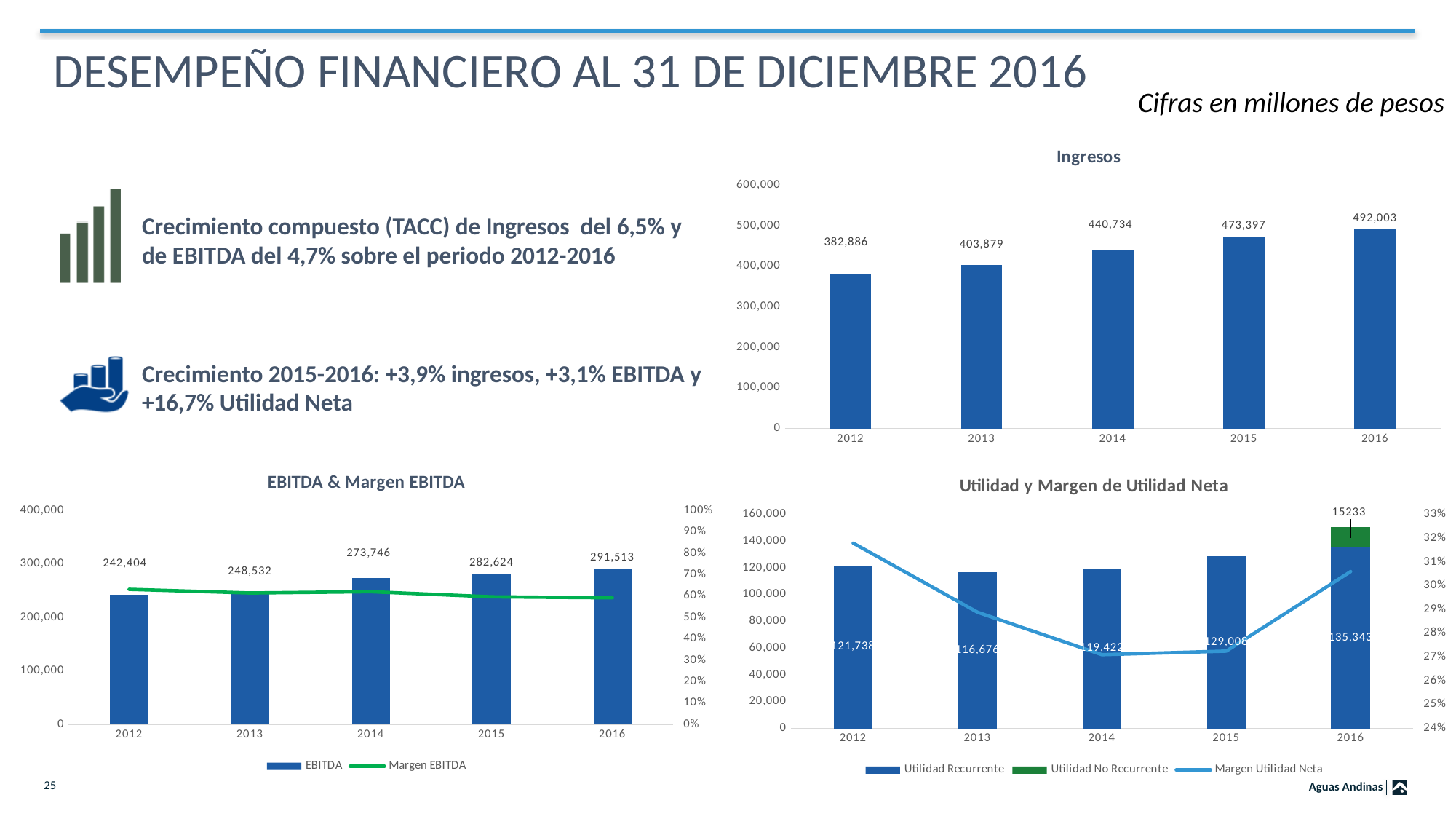
In the EBITDA & Margen EBITDA chart, what is the EBITDA value for 2013? 248,532 In the Utilidad y Margen de Utilidad Neta chart, which is larger, the Utilidad Recurrente for 2013 or for 2014? 2014 In the Ingresos chart, what is the value for 2014? 440,734 In the EBITDA & Margen EBITDA chart, is the Margen EBITDA for 2012 greater or less than 50%? greater In the EBITDA & Margen EBITDA chart, which year has the lowest EBITDA? 2012 In the Utilidad y Margen de Utilidad Neta chart, is the Margen Utilidad Neta for 2012 greater or less than 30%? greater In the Ingresos chart, do the values rise or fall from 2012 to 2016? rise In the Ingresos chart, which year has the highest value? 2016 In the EBITDA & Margen EBITDA chart, how many series does the legend list? 2 In the Utilidad y Margen de Utilidad Neta chart, what is the total of the stacked bar for 2016? 150,576 In the Utilidad y Margen de Utilidad Neta chart, what is the Utilidad Recurrente value for 2015? 129,008 In the Ingresos chart, what is the difference between the 2016 and 2012 values? 109,117